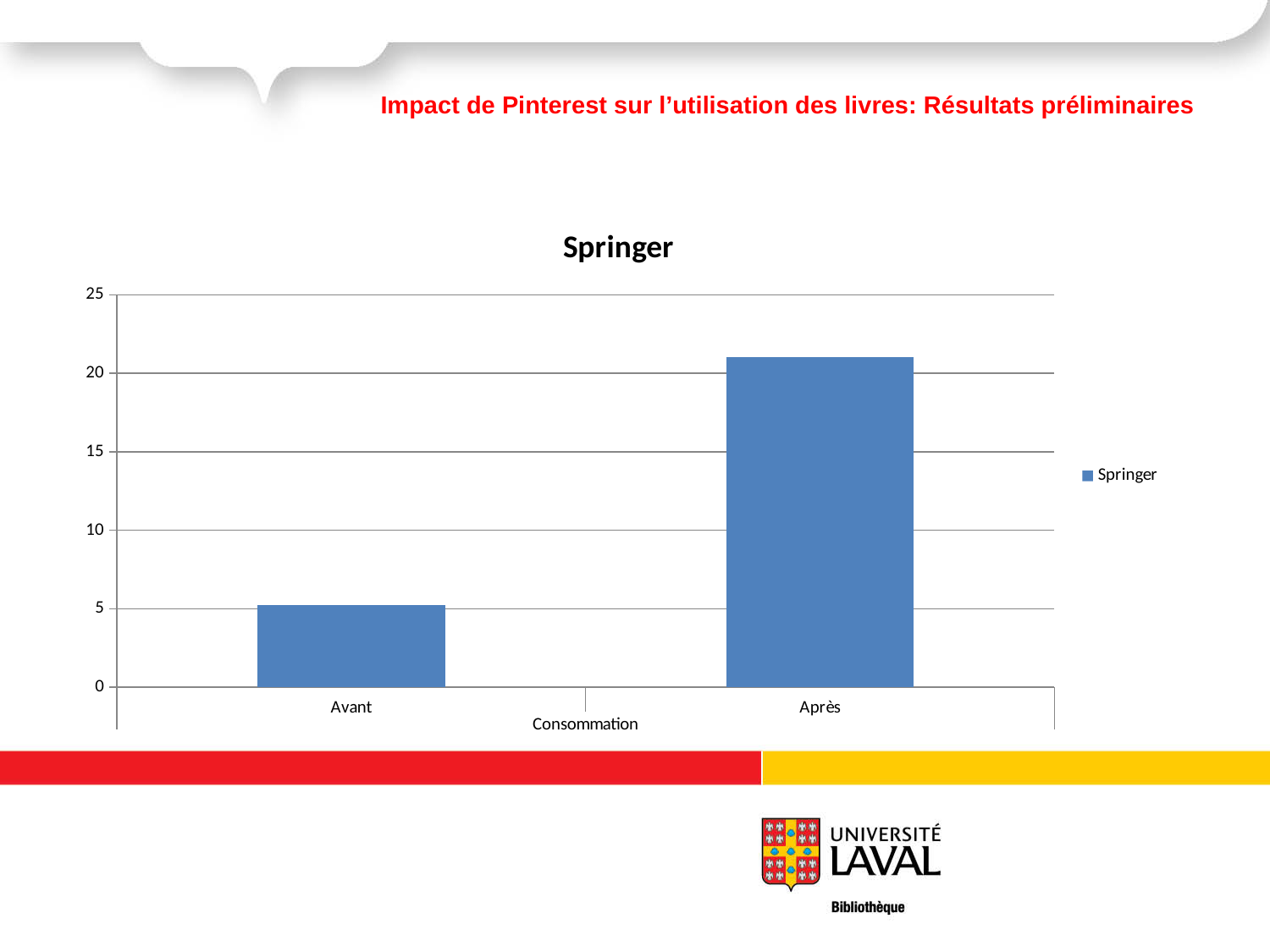
Which category has the lowest value in the chart? Avant Which category has the highest value in the chart? Après How many series does the legend list? 1 Is the value for Après greater or less than 25? less What is the title of the chart? Springer Which is larger, the value for Avant or the value for Après? Après How many categories are shown on the x axis of the chart? 2 Is the value for Après greater or less than 15? greater Do the values rise or fall from Avant to Après along the x axis? rise What type of chart is shown on the slide? bar chart What is the label of the x axis of the chart? Consommation Is the value for Avant greater or less than 10? less